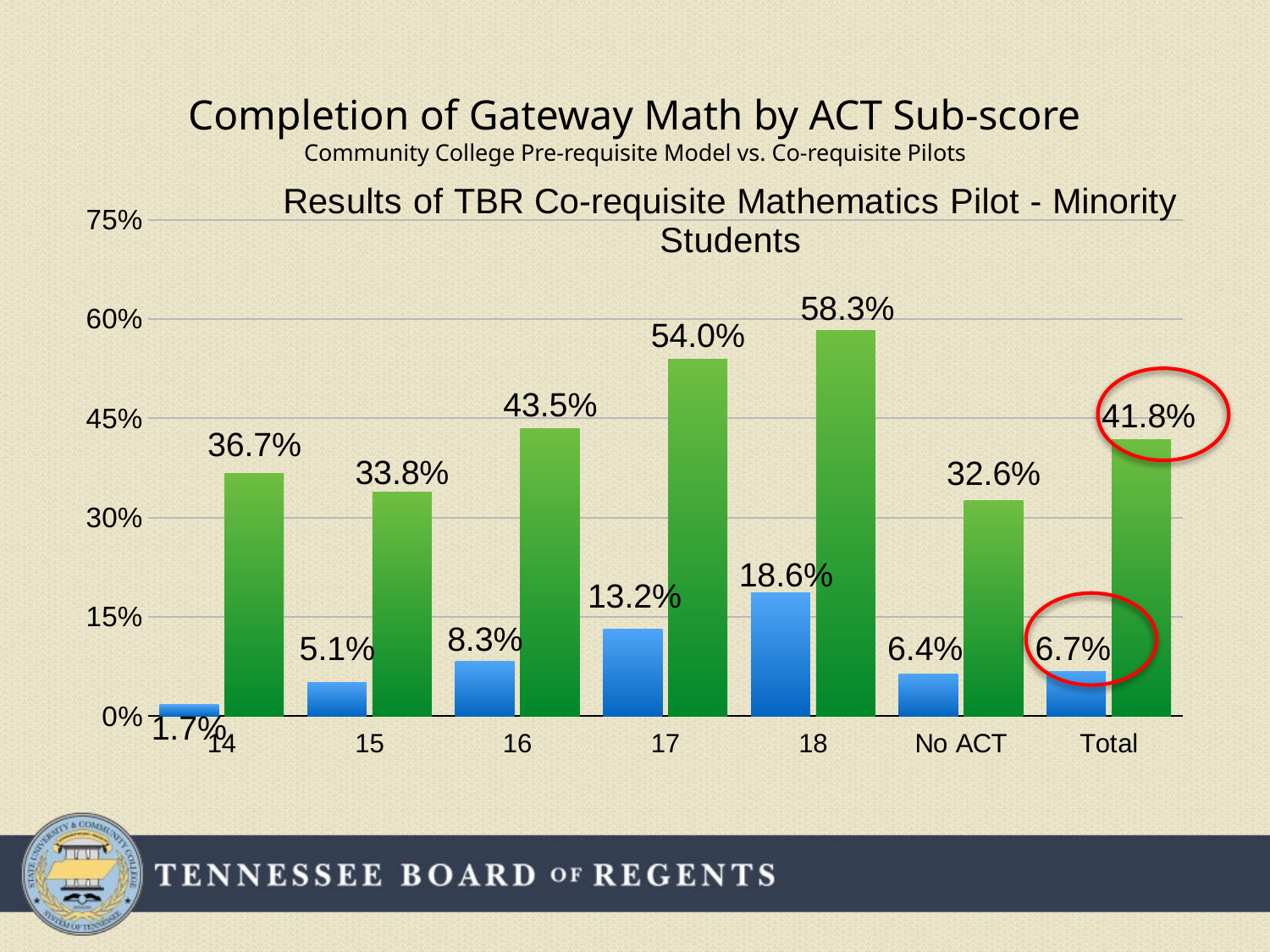
Which category has the highest green bar? 18 What is the value of the green bar for the Total category? 41.8% Is the green bar for ACT sub-score 17 greater or less than 45%? greater What kind of chart is shown on the slide? bar chart Which category has the lowest blue bar? 14 What is the difference between the green and blue bars for ACT sub-score 16? 35.2% How many categories are shown on the x axis? 7 Which is larger, the green bar for ACT sub-score 15 or the green bar for No ACT? 15 What is the value of the green bar for ACT sub-score 18? 58.3% What is the value of the blue bar for ACT sub-score 17? 13.2% Do the blue bars rise or fall from ACT sub-score 14 to 18? rise What is the value of the blue bar for the No ACT category? 6.4%